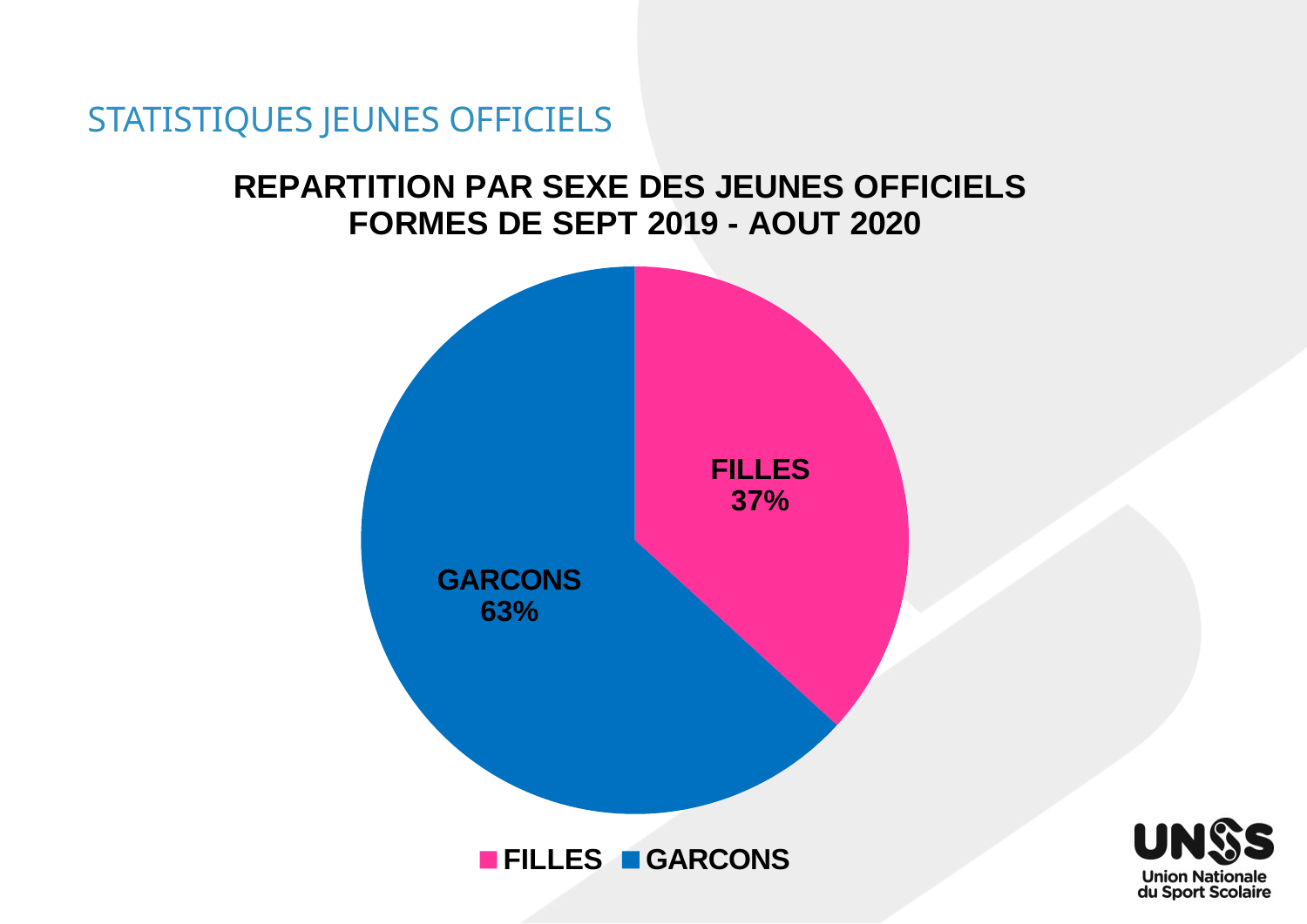
What is the difference in percentage points between GARCONS and FILLES? 26 What share of the pie does FILLES represent? 37% What kind of chart is shown on the slide? Pie chart How many categories are shown in the pie chart? 2 How many entries does the legend list? 2 What is the title of the chart? REPARTITION PAR SEXE DES JEUNES OFFICIELS FORMES DE SEPT 2019 - AOUT 2020 What share of the pie does GARCONS represent? 63% Which is larger, the share for FILLES or the share for GARCONS? GARCONS What colour is the GARCONS slice? Blue Which category has the largest slice of the pie? GARCONS Which category has the smallest slice of the pie? FILLES